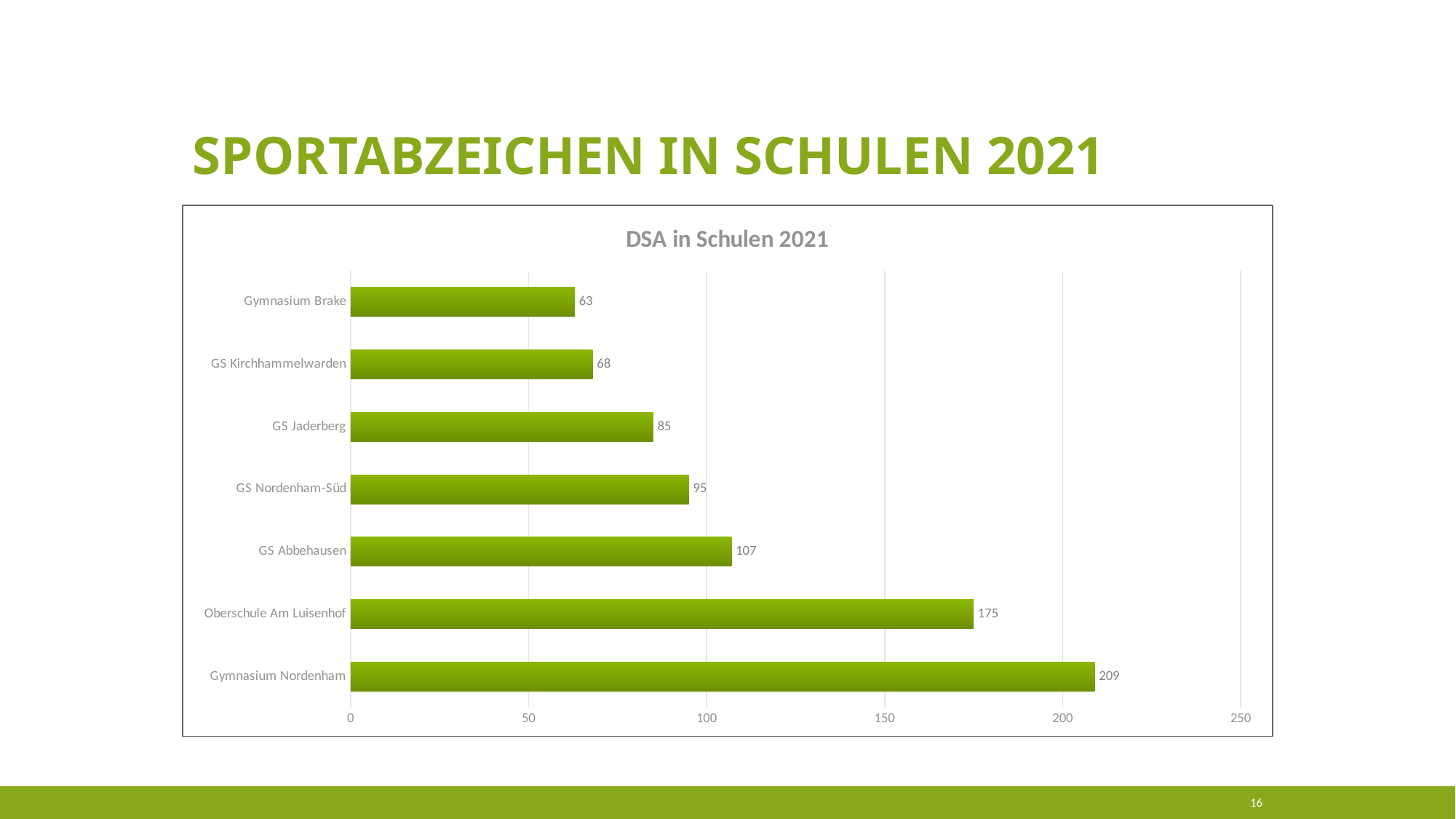
Which school has the lowest value? Gymnasium Brake How many schools are shown in the chart? 7 What is the value for GS Jaderberg? 85 What is the value for Gymnasium Nordenham? 209 What is the difference between the values for GS Abbehausen and GS Nordenham-Süd? 12 Is the value for GS Abbehausen greater or less than 100? greater What is the title of the chart? DSA in Schulen 2021 Which school has the highest value? Gymnasium Nordenham Which is larger, the value for GS Kirchhammelwarden or the value for GS Jaderberg? GS Jaderberg What is the value for Oberschule Am Luisenhof? 175 What kind of chart is shown on the slide? bar chart What is the difference between the values for Gymnasium Nordenham and Oberschule Am Luisenhof? 34